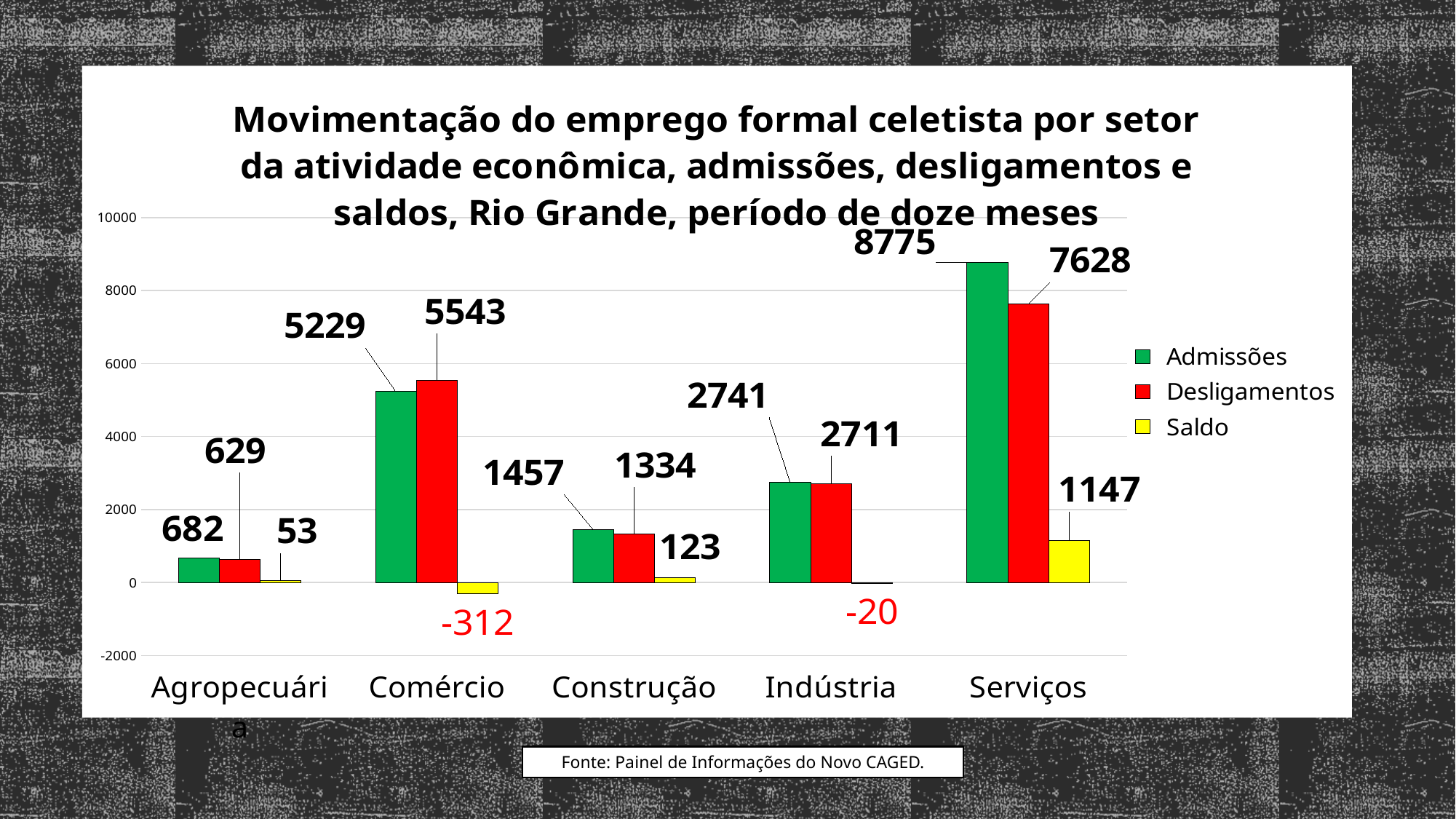
Which sector has the highest Admissões? Serviços What is the value of Admissões for Serviços? 8775 What kind of chart is shown? Bar chart What colour represents Saldo in the legend? Yellow What is the difference between Admissões and Desligamentos for Construção? 123 What is the value of Desligamentos for Comércio? 5543 What is the Saldo for Comércio? -312 Which is larger for Comércio, Admissões or Desligamentos? Desligamentos What is the Saldo for Indústria? -20 How many sectors are shown on the x axis? 5 Which sector has the lowest Saldo? Comércio How many series does the legend list? 3